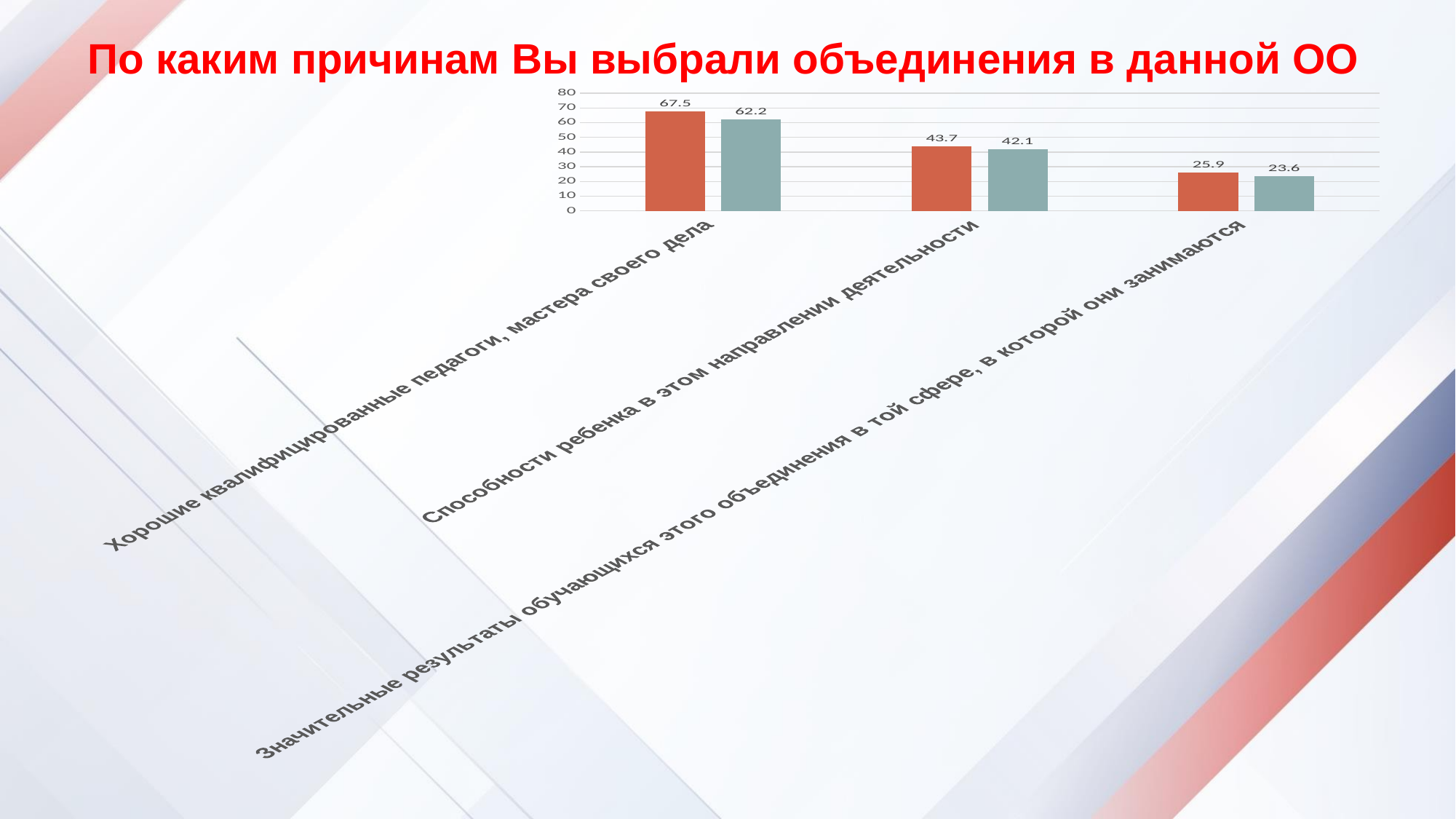
What is the value of the teal bar for 'Значительные результаты обучающихся этого объединения в той сфере, в которой они занимаются'? 23.6 What type of chart is shown on the slide? bar chart What is the value of the orange bar for the category 'Хорошие квалифицированные педагоги, мастера своего дела'? 67.5 Which category has the lowest teal bar? Значительные результаты обучающихся этого объединения в той сфере, в которой они занимаются Which is larger for 'Способности ребенка в этом направлении деятельности': the orange bar or the teal bar? the orange bar Do the orange bar values rise or fall from left to right across the categories? fall How many categories are shown on the x axis of the chart? 3 Which category has the highest orange bar? Хорошие квалифицированные педагоги, мастера своего дела What is the value of the orange bar for 'Способности ребенка в этом направлении деятельности'? 43.7 Is the orange bar for 'Значительные результаты обучающихся этого объединения в той сфере, в которой они занимаются' greater or less than 30? less What is the difference between the orange and teal bars for 'Хорошие квалифицированные педагоги, мастера своего дела'? 5.3 What is the value of the teal bar for the category 'Хорошие квалифицированные педагоги, мастера своего дела'? 62.2